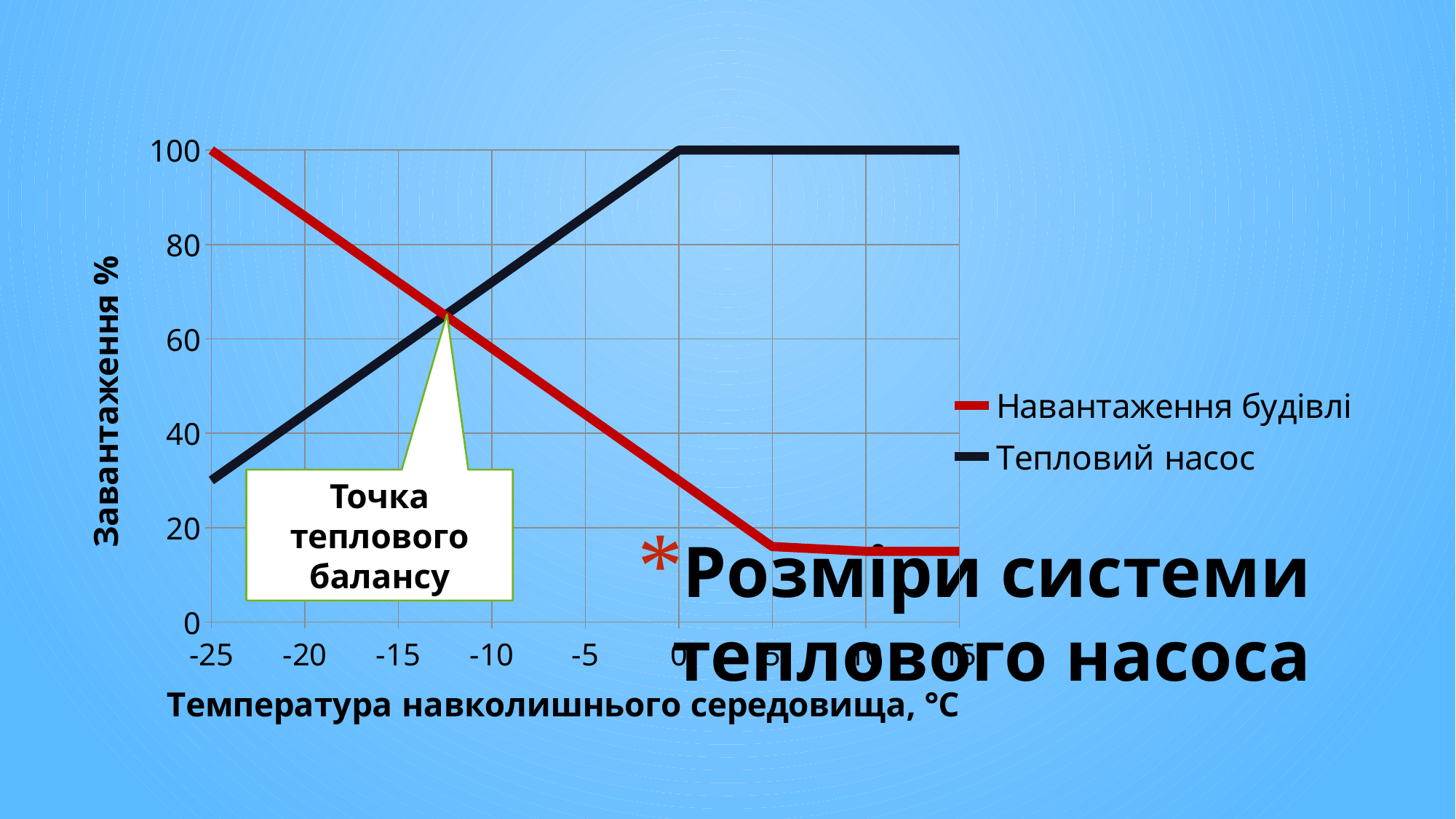
Is the value of Навантаження будівлі at 5 °C greater or less than 20? less At -20 °C, which series has the larger value, Навантаження будівлі or Тепловий насос? Навантаження будівлі What is the value of Навантаження будівлі at -25 °C? 100 Does the Навантаження будівлі line rise or fall as the temperature increases from -25 °C to 5 °C? fall Is the value of Навантаження будівлі at -15 °C greater or less than 60? greater Is the value of Тепловий насос at -25 °C greater or less than 40? less What kind of chart is shown on the slide? line chart What are the two series named in the legend? Навантаження будівлі, Тепловий насос How many series does the legend list? 2 What is the value of Тепловий насос at 0 °C? 100 At -5 °C, which series has the larger value, Навантаження будівлі or Тепловий насос? Тепловий насос What is the title of the vertical axis? Завантаження %